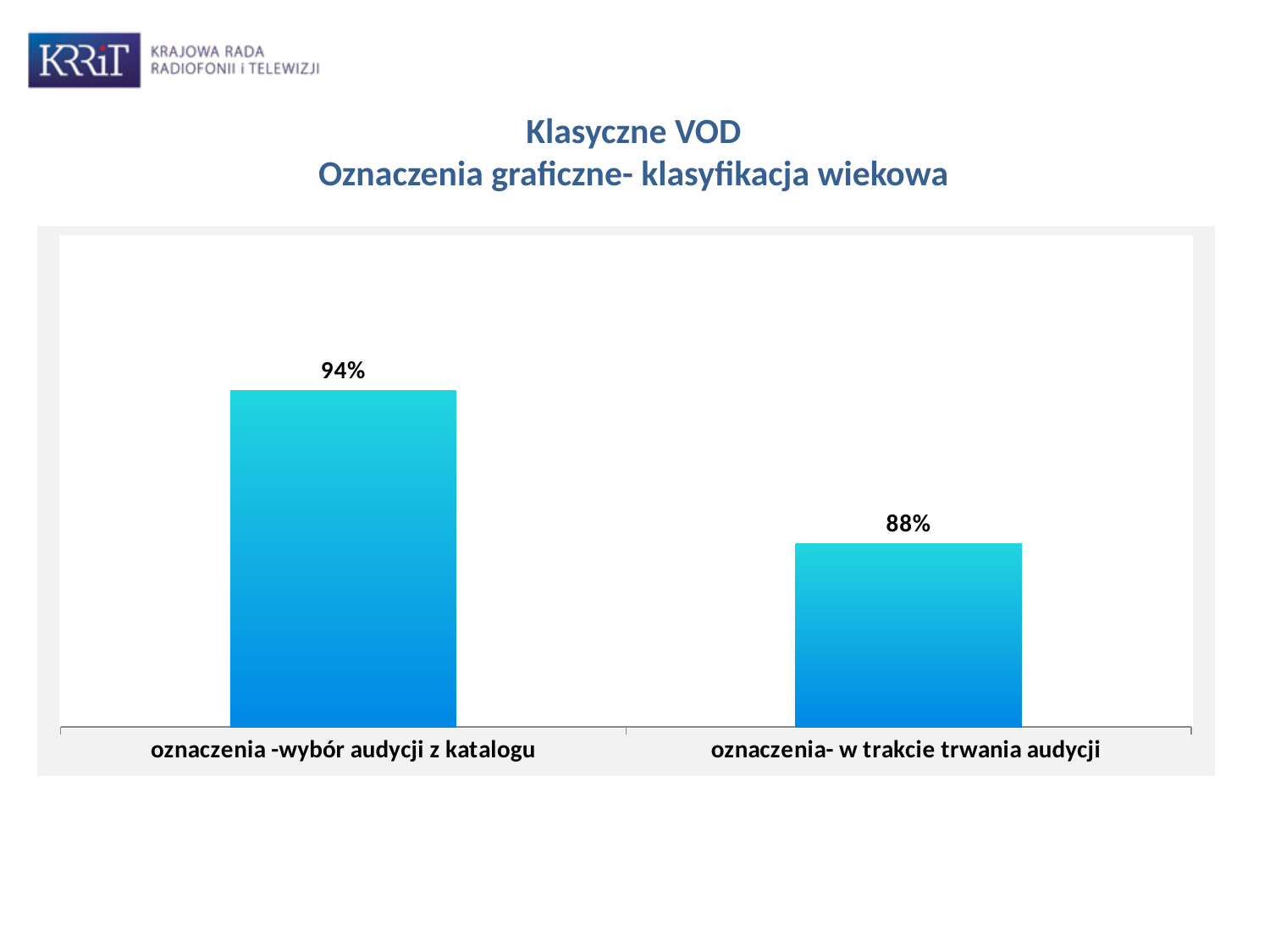
Which category has the highest value? oznaczenia -wybór audycji z katalogu What is the value for "oznaczenia -wybór audycji z katalogu"? 94% Do the values rise or fall from left to right along the x axis? fall What colour are the bars in the chart? blue What is the difference between the values for "oznaczenia -wybór audycji z katalogu" and "oznaczenia- w trakcie trwania audycji"? 6% What is the title shown above the chart? Klasyczne VOD Oznaczenia graficzne- klasyfikacja wiekowa How many categories are shown in the chart? 2 Which category has the lowest value? oznaczenia- w trakcie trwania audycji What is the value for "oznaczenia- w trakcie trwania audycji"? 88% What kind of chart is shown on the slide? bar chart Which is larger: the value for "oznaczenia -wybór audycji z katalogu" or for "oznaczenia- w trakcie trwania audycji"? oznaczenia -wybór audycji z katalogu